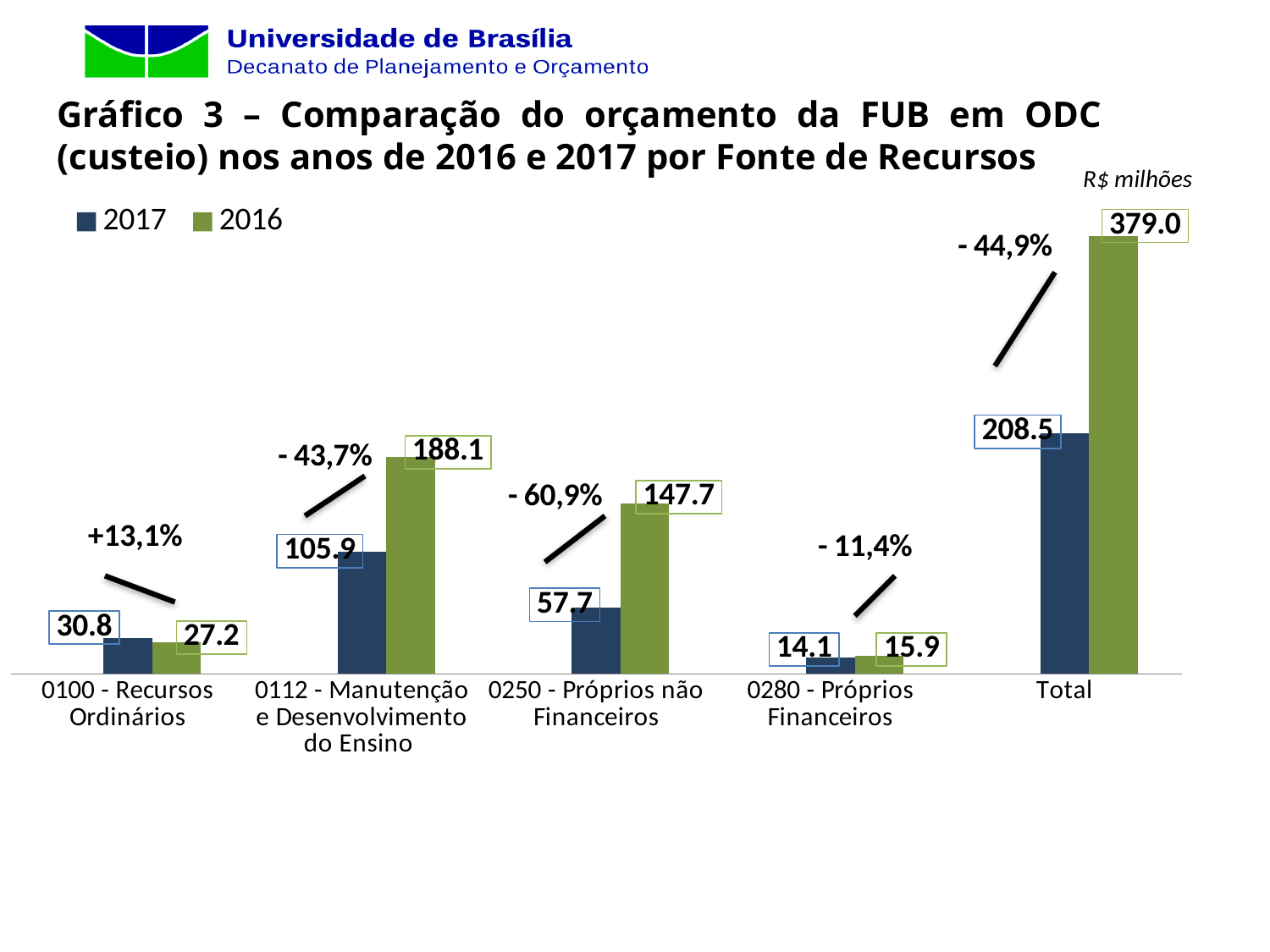
Which is larger for 0100 - Recursos Ordinários, the 2017 value or the 2016 value? 2017 What kind of chart is this? bar chart What is the 2017 value for 0112 - Manutenção e Desenvolvimento do Ensino? 105.9 What is the difference between the 2016 and 2017 values for Total? 170.5 What is the 2016 value for 0250 - Próprios não Financeiros? 147.7 What is the 2016 value for 0100 - Recursos Ordinários? 27.2 What percentage change is annotated for 0250 - Próprios não Financeiros? - 60,9% How many series does the legend list? 2 What is the 2017 value for Total? 208.5 How many categories are shown on the x axis? 5 Excluding Total, which category has the highest 2016 value? 0112 - Manutenção e Desenvolvimento do Ensino Which category has the lowest 2017 value? 0280 - Próprios Financeiros